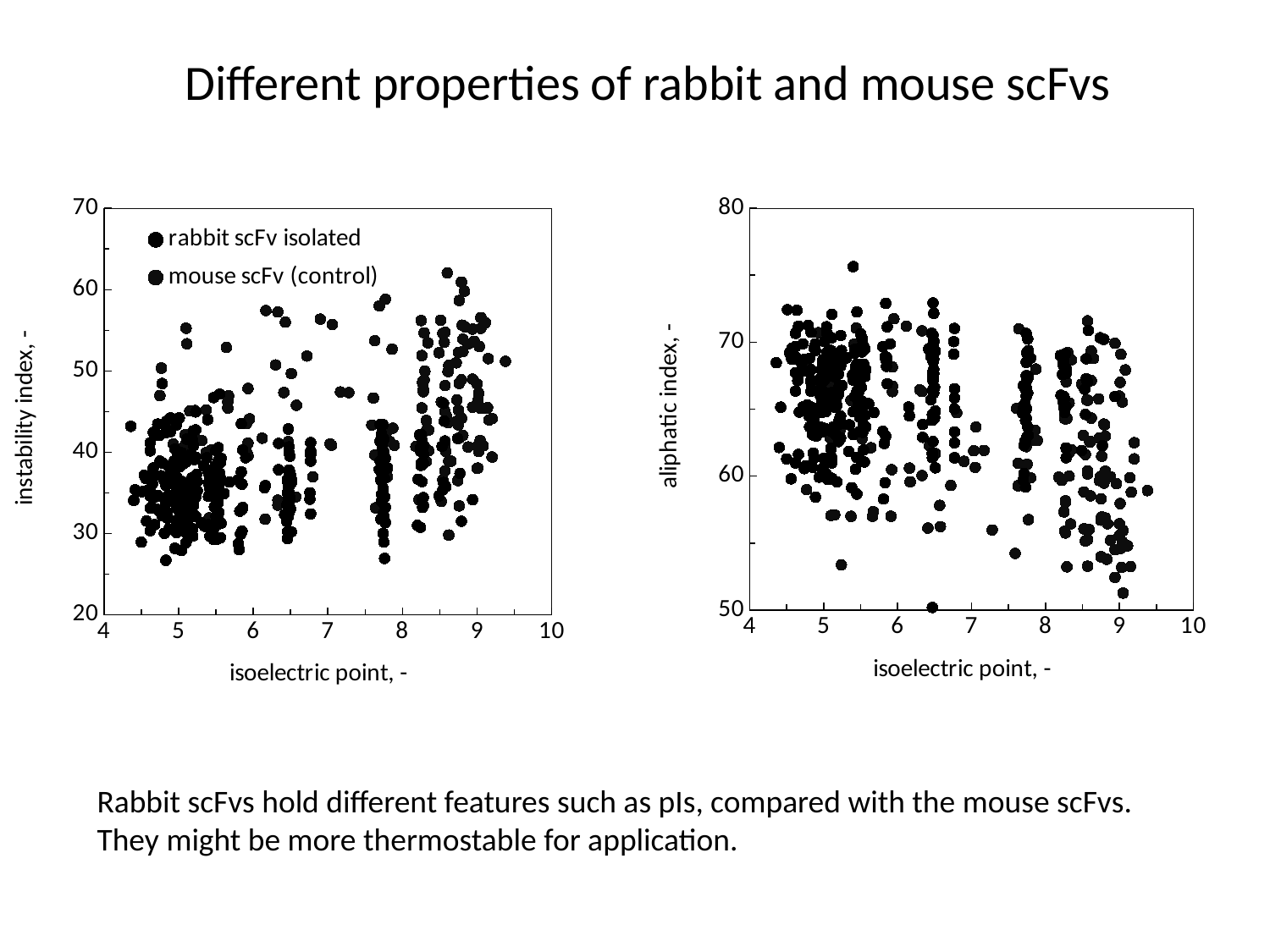
On the left chart (instability index), is the lowest plotted point greater or less than 30? less What is the x-axis label shared by both charts? isoelectric point, - On the left chart (instability index), how many series does the legend list? 2 On the right chart (aliphatic index), is the lowest plotted point greater or less than 60? less What kind of chart is the left chart, titled with y-axis 'instability index, -'? scatter chart What kind of chart is the right chart, with y-axis 'aliphatic index, -'? scatter chart On the left chart (instability index), what are the two series named in the legend? rabbit scFv isolated; mouse scFv (control) On the left chart (instability index), is the highest plotted point greater or less than 50? greater